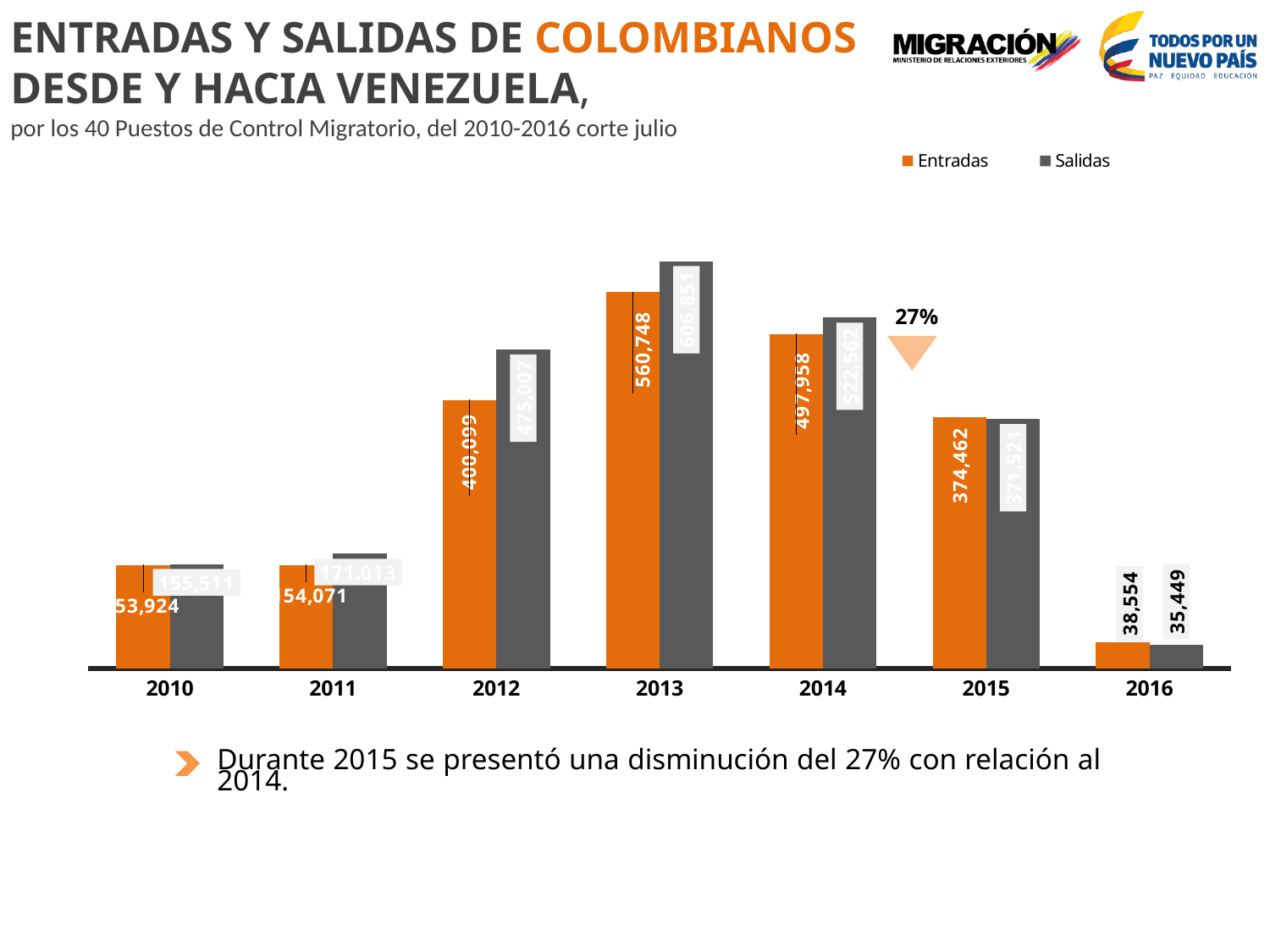
What kind of chart is shown on the slide? Bar chart In which year is the value of Entradas highest? 2013 How many series does the legend list? 2 In which year is the value of Entradas lowest? 2016 What is the difference between Entradas in 2013 and Entradas in 2014? 62,790 In 2016, which is larger, Entradas or Salidas? Entradas What is the value of Entradas for 2012? 400,099 Do the Entradas values rise or fall from 2013 to 2016? Fall What is the value of Entradas for 2013? 560,748 How many years are shown on the x axis of the chart? 7 What is the value of Salidas for 2016? 35,449 What is the value of Entradas for 2015? 374,462